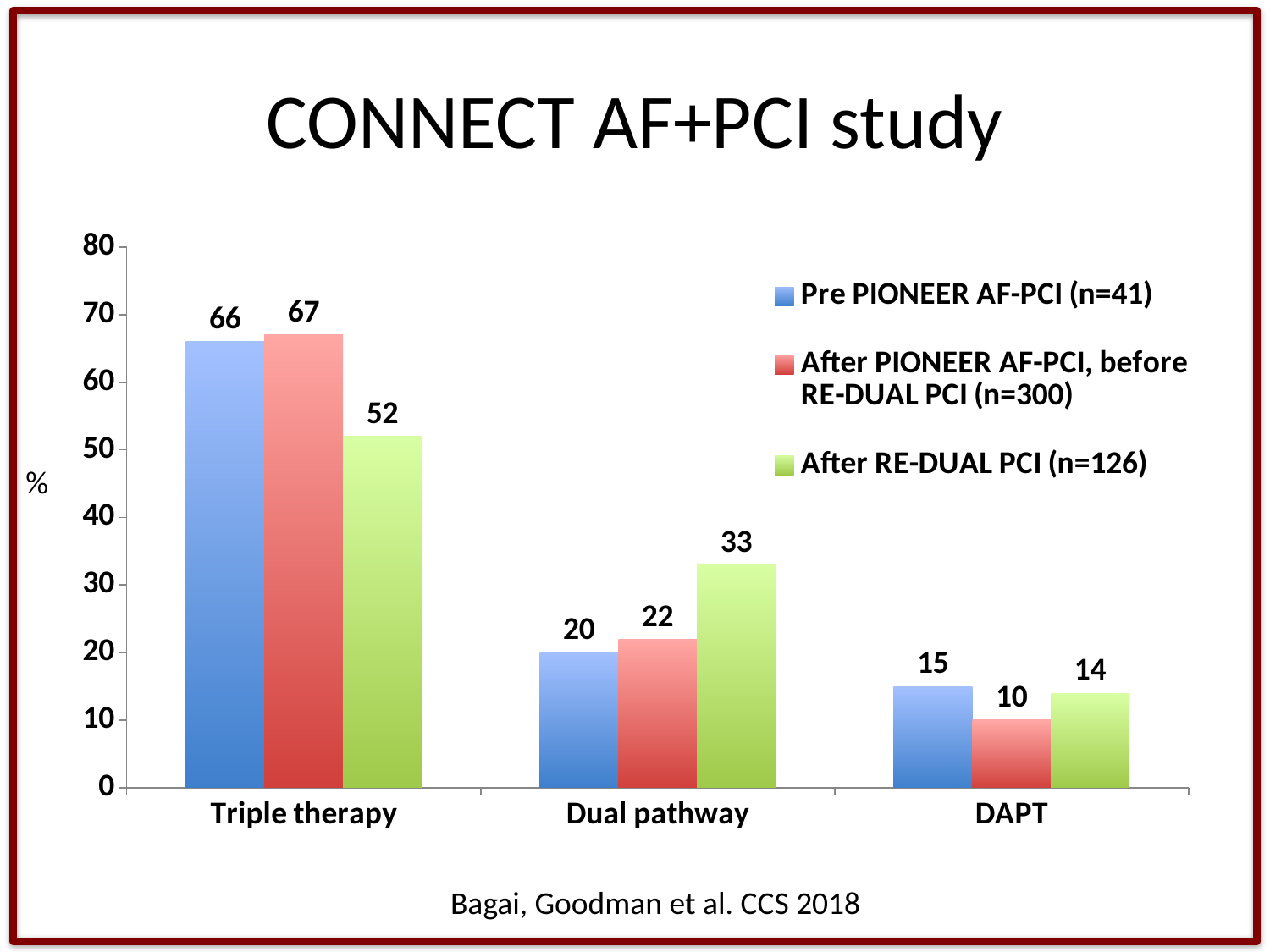
How many categories are shown on the x axis? 3 What is the difference between the Pre PIONEER AF-PCI (n=41) and After RE-DUAL PCI (n=126) values for Triple therapy? 14 How many series does the legend list? 3 What is the title of the chart? CONNECT AF+PCI study What is the value for Dual pathway in the After RE-DUAL PCI (n=126) series? 33 Is the value for Triple therapy in the After RE-DUAL PCI (n=126) series greater or less than 60? less Which category has the lowest value in the After PIONEER AF-PCI, before RE-DUAL PCI (n=300) series? DAPT What is the value for DAPT in the After PIONEER AF-PCI, before RE-DUAL PCI (n=300) series? 10 Which is larger for Dual pathway: the Pre PIONEER AF-PCI (n=41) value or the After RE-DUAL PCI (n=126) value? After RE-DUAL PCI (n=126) Which category has the highest value in the After RE-DUAL PCI (n=126) series? Triple therapy What is the value for Triple therapy in the Pre PIONEER AF-PCI (n=41) series? 66 What kind of chart is shown on the slide? bar chart